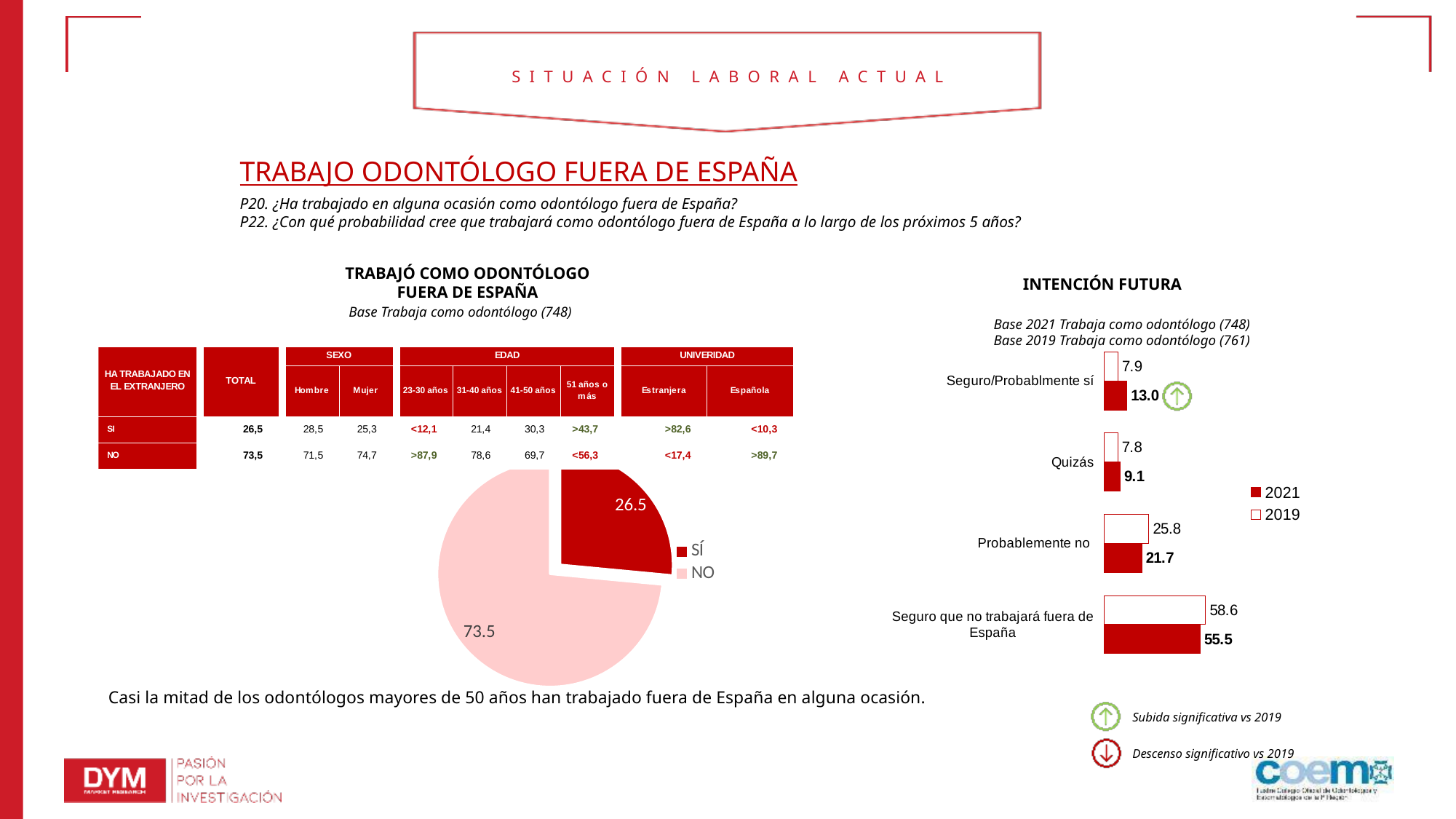
In the pie chart, which slice is larger, SÍ or NO? NO In the INTENCIÓN FUTURA chart, what is the difference between the 2021 and 2019 values for Seguro/Probablmente sí? 5.1 How many series does the legend of the INTENCIÓN FUTURA chart list? 2 How many categories are shown in the INTENCIÓN FUTURA chart? 4 In the INTENCIÓN FUTURA chart, for Probablemente no, which year has the larger value, 2021 or 2019? 2019 In the pie chart, what percentage of respondents answered SÍ? 26.5 What kind of chart is the chart with the SÍ and NO slices? pie chart In the INTENCIÓN FUTURA chart, what is the 2021 value for Quizás? 9.1 In the pie chart, what value is shown for the NO slice? 73.5 In the INTENCIÓN FUTURA chart, which category has the highest 2021 value? Seguro que no trabajará fuera de España What kind of chart is the INTENCIÓN FUTURA chart? bar chart In the INTENCIÓN FUTURA chart, what is the 2019 value for Probablemente no? 25.8